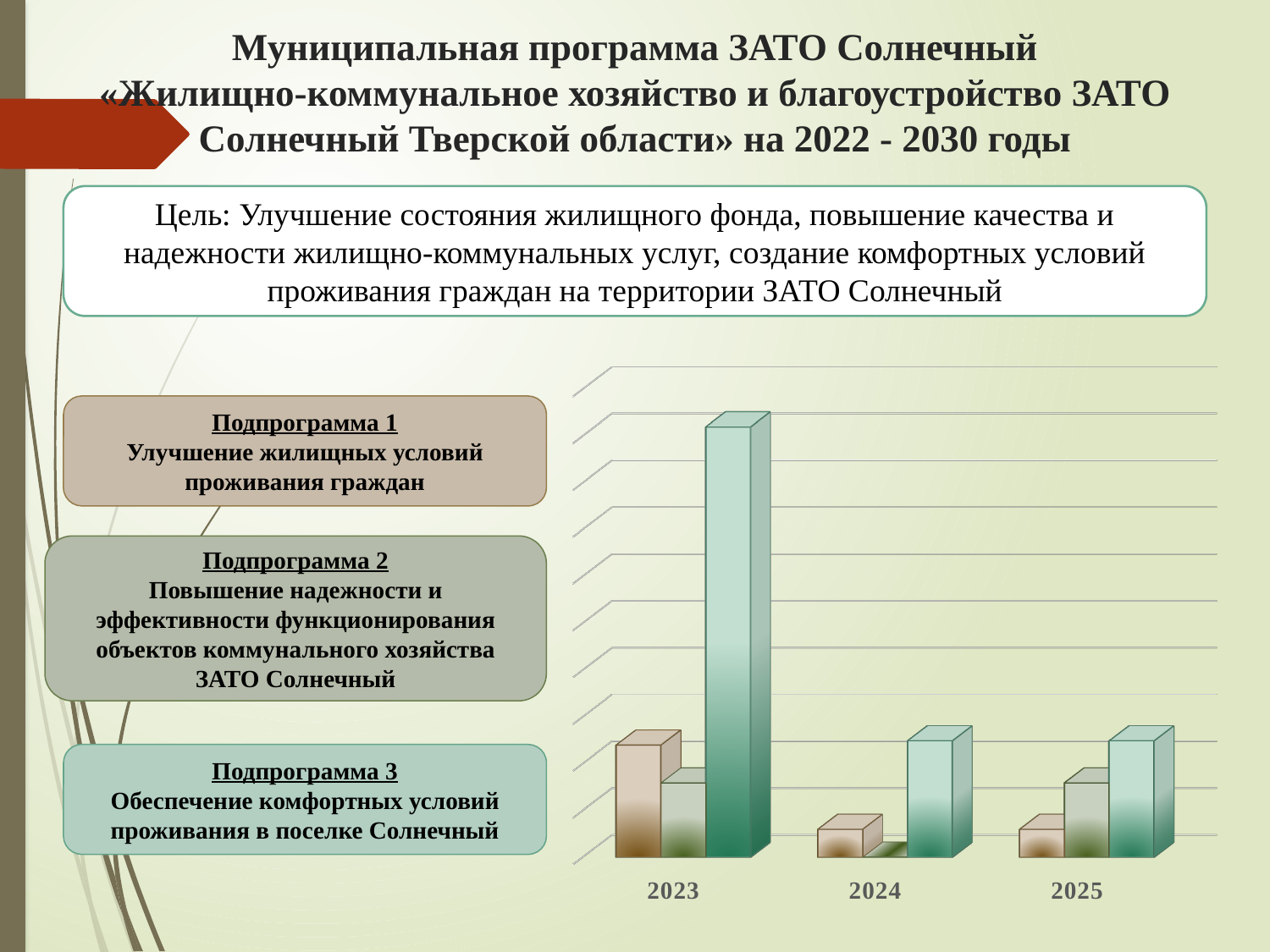
Does the grey-green (second) bar rise or fall from 2024 to 2025? rise Which year has the tallest bar in the chart? 2023 What kind of chart is shown on the slide? bar chart How many years are shown on the x axis of the chart? 3 Within 2024, which bar is the tallest: the first, second or third? third Within 2023, which bar is the shortest: the first, second or third? second Which year has the shortest grey-green (second) bar? 2024 Does the teal (third) bar rise or fall from 2023 to 2024? fall Which years are shown on the x axis of the chart? 2023, 2024, 2025 Is the teal (third) bar for 2023 larger or smaller than the teal bar for 2024? larger Is the tan (first) bar for 2023 larger or smaller than the tan bar for 2024? larger